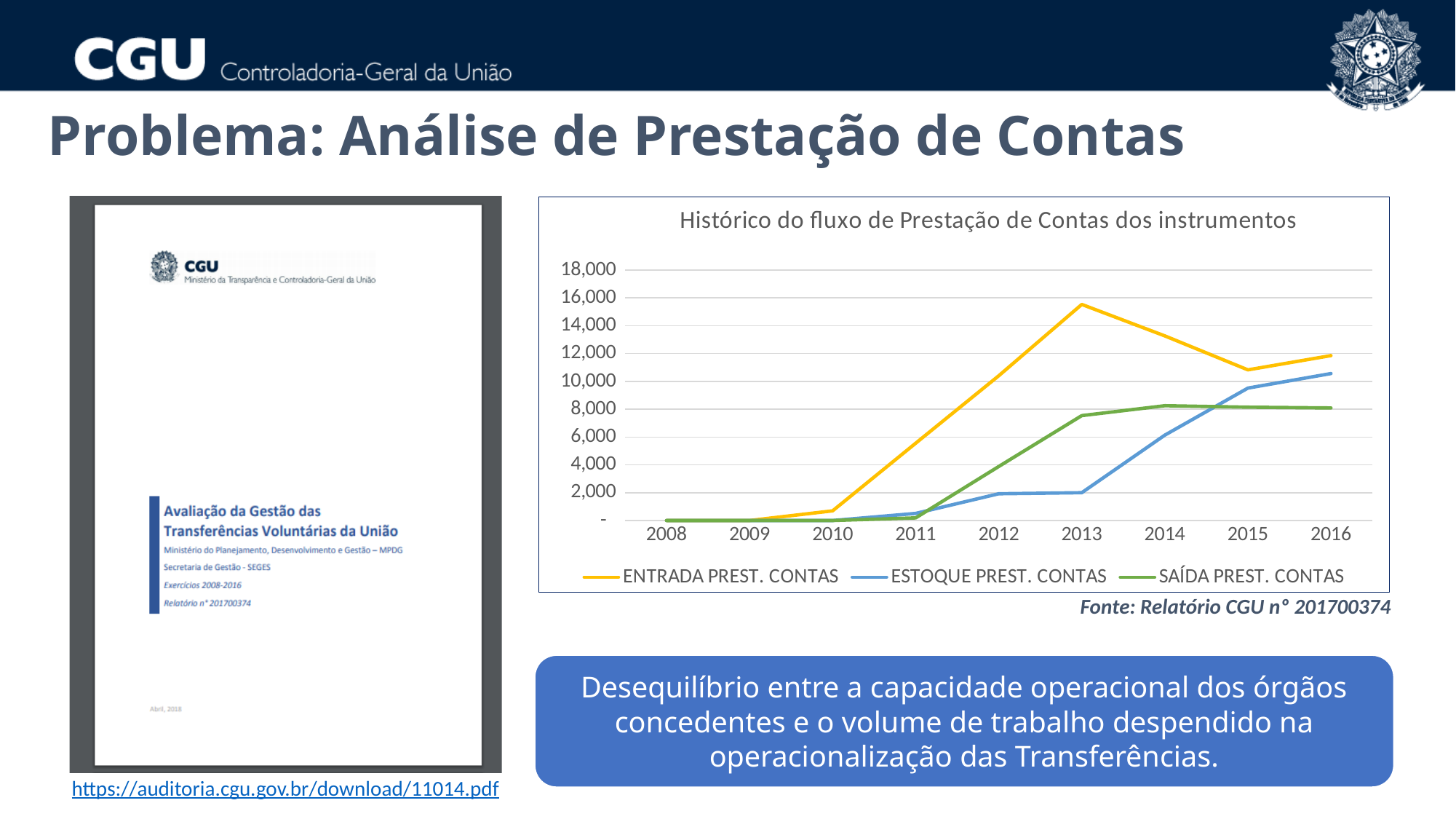
How many series does the chart's legend list? 3 In 2016, which series has the higher value: ENTRADA PREST. CONTAS or ESTOQUE PREST. CONTAS? ENTRADA PREST. CONTAS Is the value for ESTOQUE PREST. CONTAS in 2016 greater or less than 10,000? greater Is the value for ENTRADA PREST. CONTAS in 2013 greater or less than 14,000? greater How many years are shown on the x axis of the chart? 9 In 2013, which series has the higher value: ESTOQUE PREST. CONTAS or SAÍDA PREST. CONTAS? SAÍDA PREST. CONTAS What is the title of the chart? Histórico do fluxo de Prestação de Contas dos instrumentos What kind of chart is shown on the slide? line chart In which year does the ENTRADA PREST. CONTAS series reach its highest value? 2013 Does the ESTOQUE PREST. CONTAS series rise or fall from 2008 to 2016? rise Is the value for ESTOQUE PREST. CONTAS in 2013 greater or less than 4,000? less